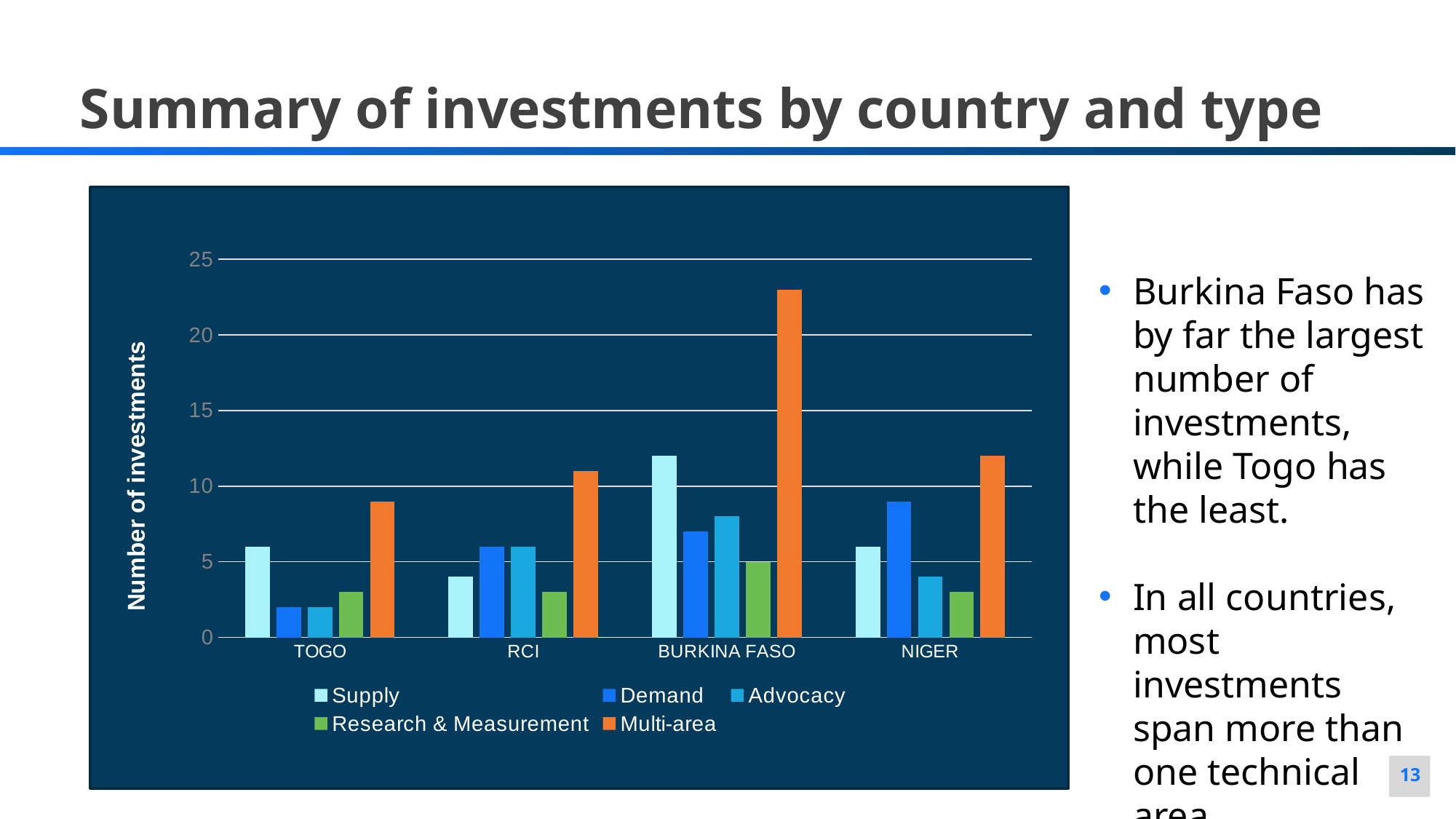
Is the Supply value for Burkina Faso greater or less than 10? greater Is the Demand value for Togo greater or less than 5? less What kind of chart is shown on the slide? bar chart How many countries are shown on the x axis of the chart? 4 Which investment type has the tallest bar for Togo? Multi-area Which country has the tallest Multi-area bar? Burkina Faso What is the title of the chart's y axis? Number of investments Which investment type has the shortest bar for Burkina Faso? Research & Measurement Is the Multi-area value for Burkina Faso greater or less than 20? greater Which is larger, the Supply value for Burkina Faso or the Supply value for Niger? Burkina Faso How many series does the chart's legend list? 5